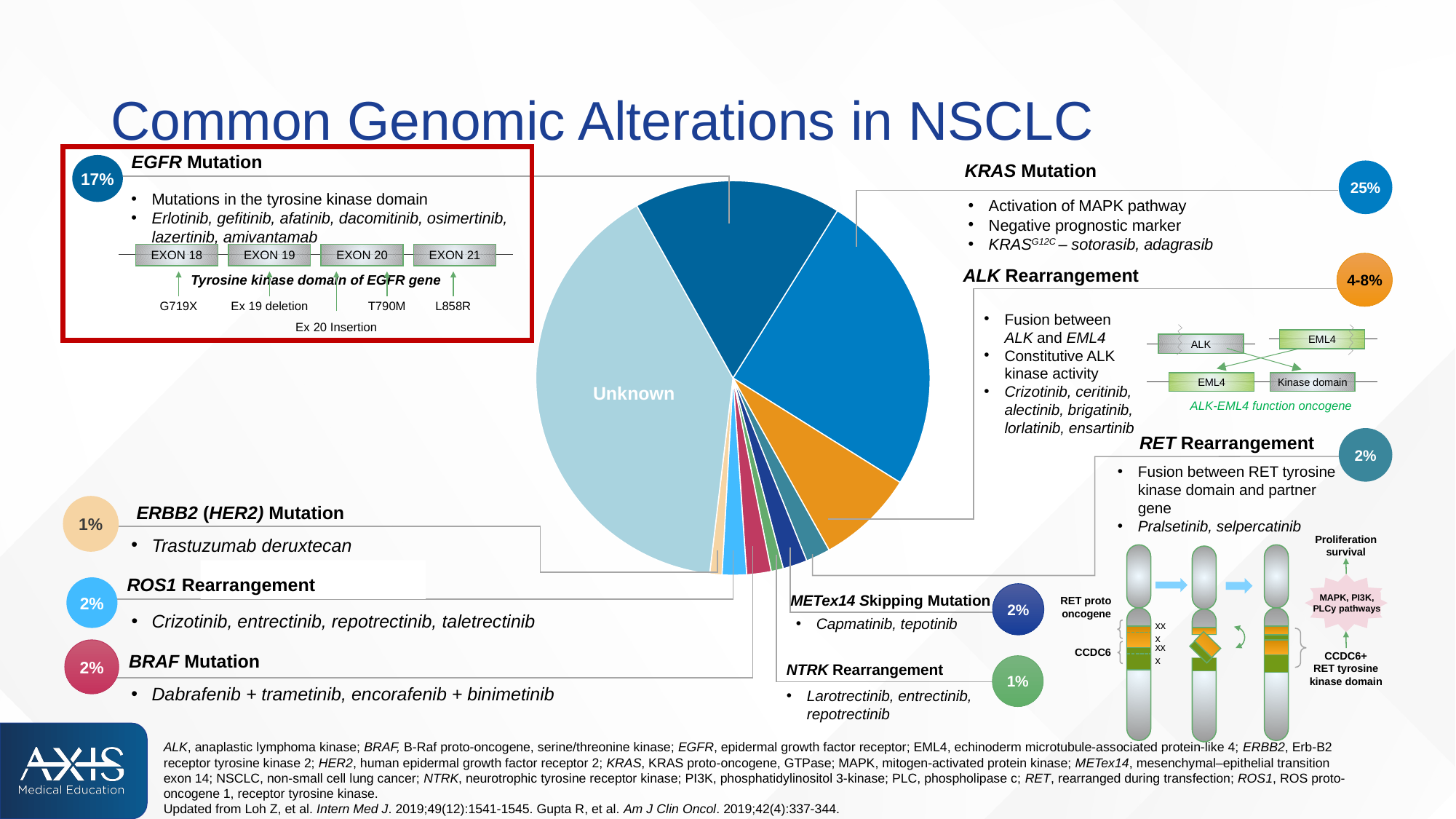
What percentage is shown for KRAS Mutation? 25% What is the difference in percentage between KRAS Mutation and EGFR Mutation? 8% Which named genomic alteration has the highest percentage on the slide? KRAS Mutation What percentage is shown for BRAF Mutation? 2% What percentage is shown for ERBB2 (HER2) Mutation? 1% What kind of chart is shown on the slide? pie chart What percentage is shown for EGFR Mutation? 17% What percentage is shown for NTRK Rearrangement? 1% What is the title of the slide containing the pie chart? Common Genomic Alterations in NSCLC Which slice of the pie chart is the largest? Unknown What percentage range is shown for ALK Rearrangement? 4-8% Which is larger, the percentage for EGFR Mutation or for KRAS Mutation? KRAS Mutation